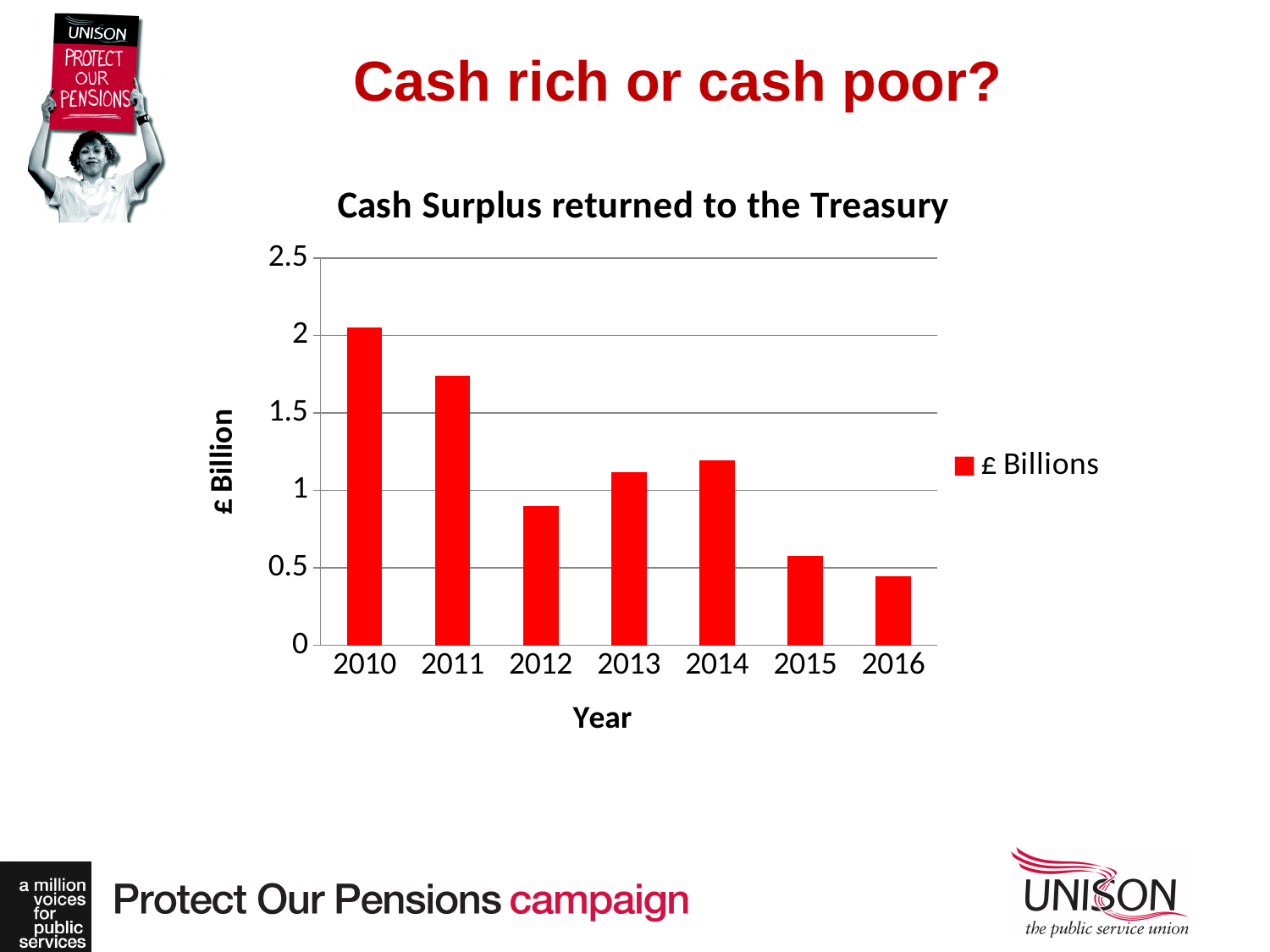
Which year has the lowest cash surplus returned to the Treasury? 2016 Which year has the highest cash surplus returned to the Treasury? 2010 How many years are shown on the x axis of the chart? 7 Is the value for 2016 greater or less than 0.5? less Is the value for 2011 greater or less than 1.5? greater Is the value for 2012 greater or less than 1? less How many series does the chart legend list? 1 What type of chart is shown on the slide? Bar chart What is the title of the chart? Cash Surplus returned to the Treasury Which year has a larger cash surplus, 2012 or 2013? 2013 Overall, do the values rise or fall from 2010 to 2016? fall